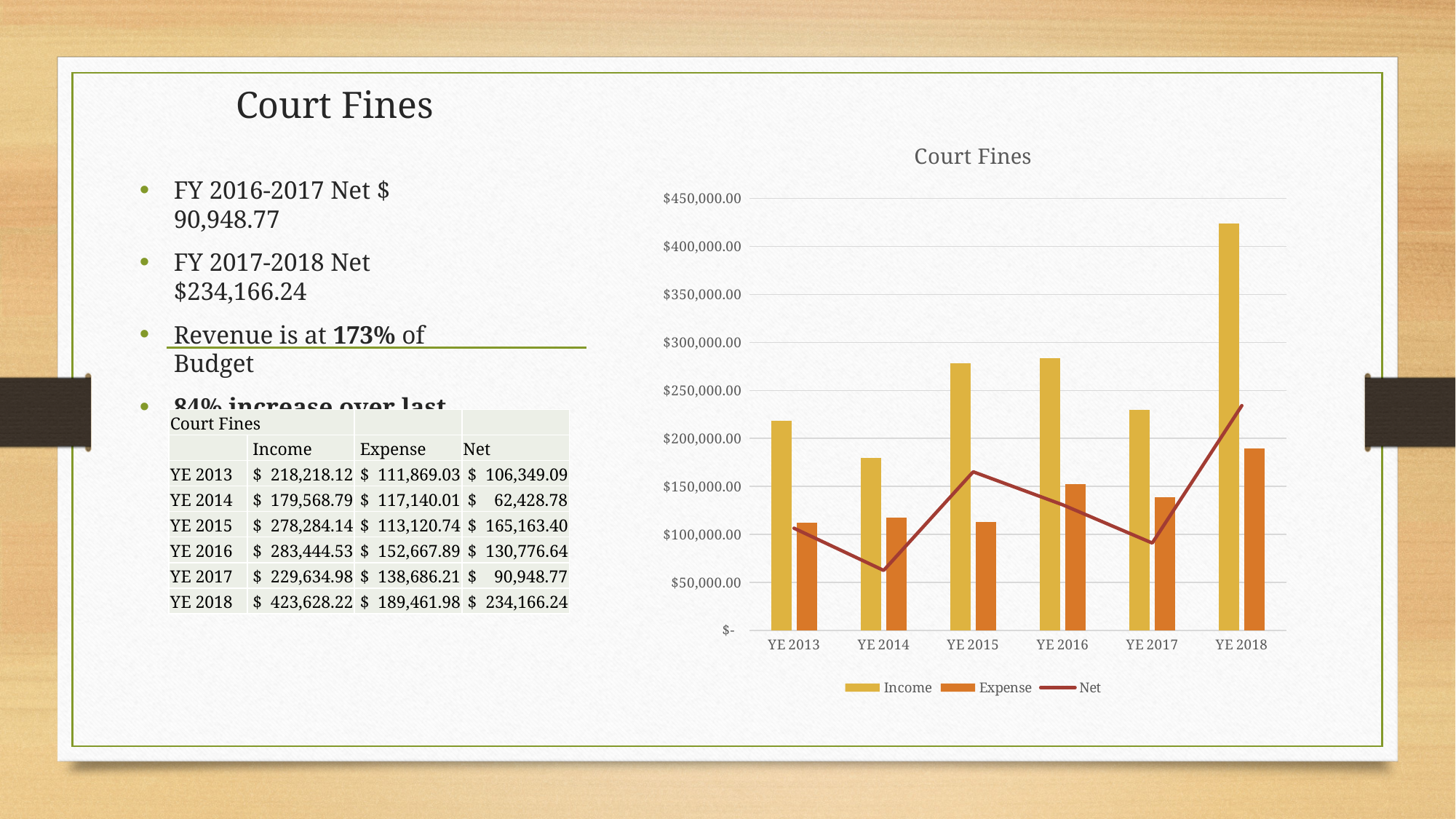
Does the Net line rise or fall from YE 2017 to YE 2018? rise How many series does the legend of the Court Fines chart list? 3 In the Court Fines chart, which year has the highest Income? YE 2018 Which is larger, the Income for YE 2015 or the Income for YE 2017? YE 2015 In the Court Fines chart, which year has the lowest Net value? YE 2014 What is the Income value for YE 2018? $423,628.22 What kind of chart is the Court Fines chart? bar chart with a line Is the Expense value for YE 2015 greater or less than $150,000.00? less Is the Income value for YE 2013 greater or less than $200,000.00? greater In the Court Fines chart, which year has the lowest Income? YE 2014 In the Court Fines chart, which year has the highest Expense? YE 2018 How many year categories are shown on the x axis of the Court Fines chart? 6